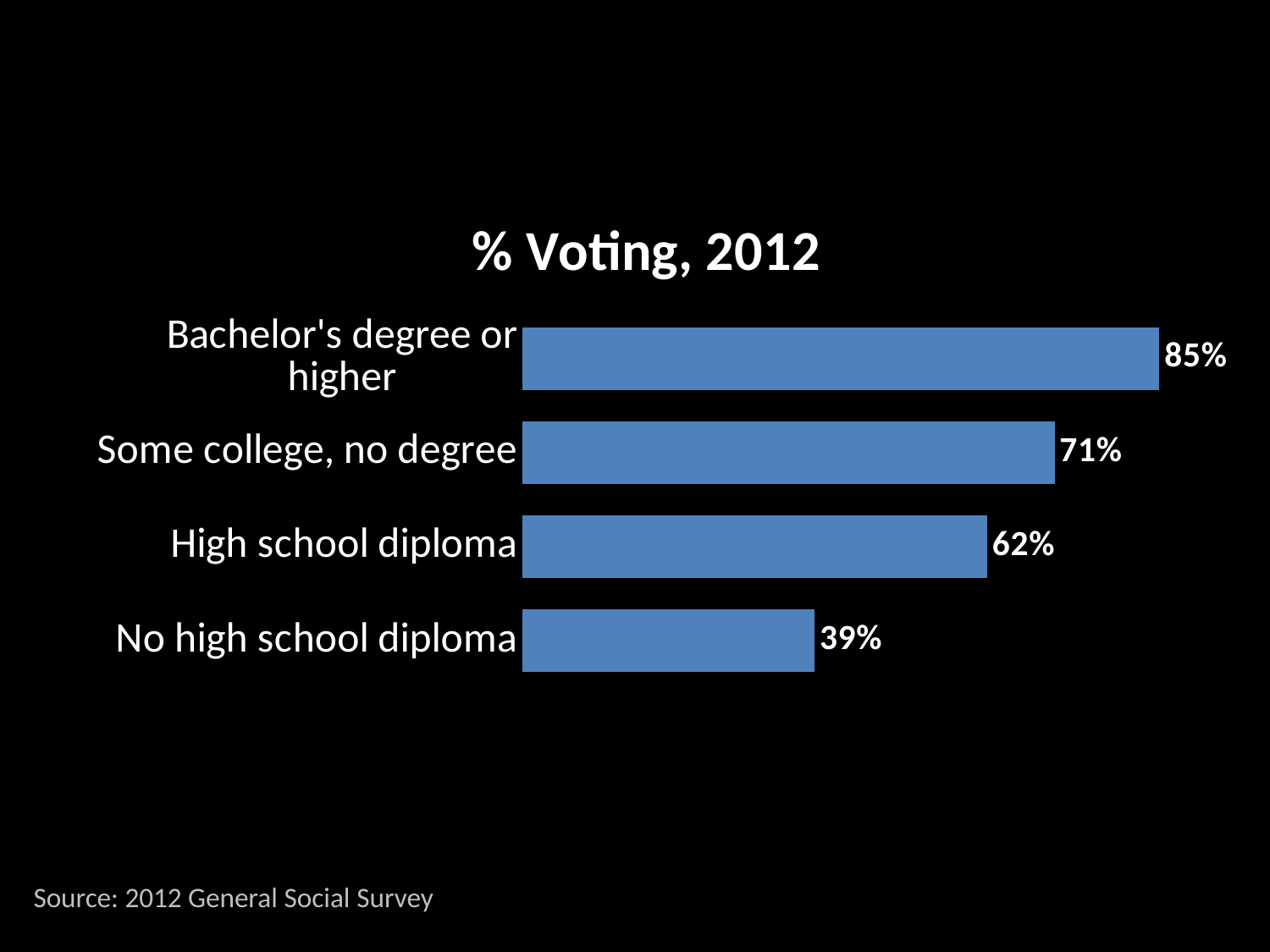
Which is larger, the value for High school diploma or the value for Some college, no degree? Some college, no degree Which category has the highest value? Bachelor's degree or higher What is the value for Some college, no degree? 71% What kind of chart is shown on the slide? Bar chart What is the value for High school diploma? 62% How many categories are shown in the chart? 4 Which category has the lowest value? No high school diploma What is the value for Bachelor's degree or higher? 85% What is the value for No high school diploma? 39% What is the difference between the values for Bachelor's degree or higher and No high school diploma? 46% What is the difference between the values for Some college, no degree and High school diploma? 9% What is the title of the chart? % Voting, 2012